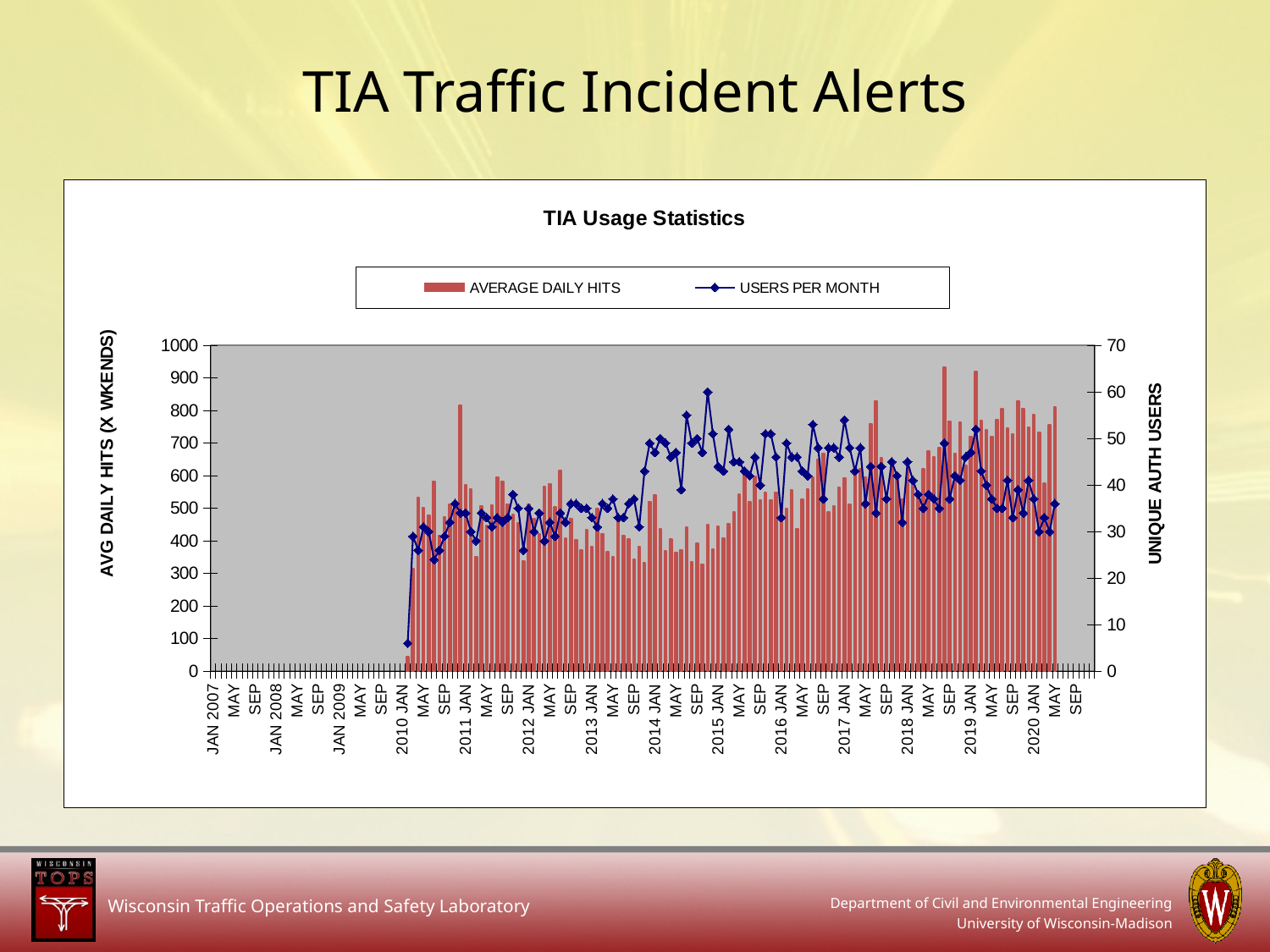
Does the USERS PER MONTH line generally rise or fall between 2010 and 2015? rise What is the title of the chart on the slide? TIA Usage Statistics Do the AVERAGE DAILY HITS bars generally rise or fall from 2015 to 2019? rise Is the USERS PER MONTH value at 2020 MAY greater or less than 40? less Is the AVERAGE DAILY HITS value at 2011 JAN greater or less than 700? less Is the peak USERS PER MONTH value around 2015 JAN greater or less than 50? greater Which series is drawn as bars in the chart? AVERAGE DAILY HITS What kind of chart is shown on the slide? A combination bar and line chart How many series does the chart's legend list? 2